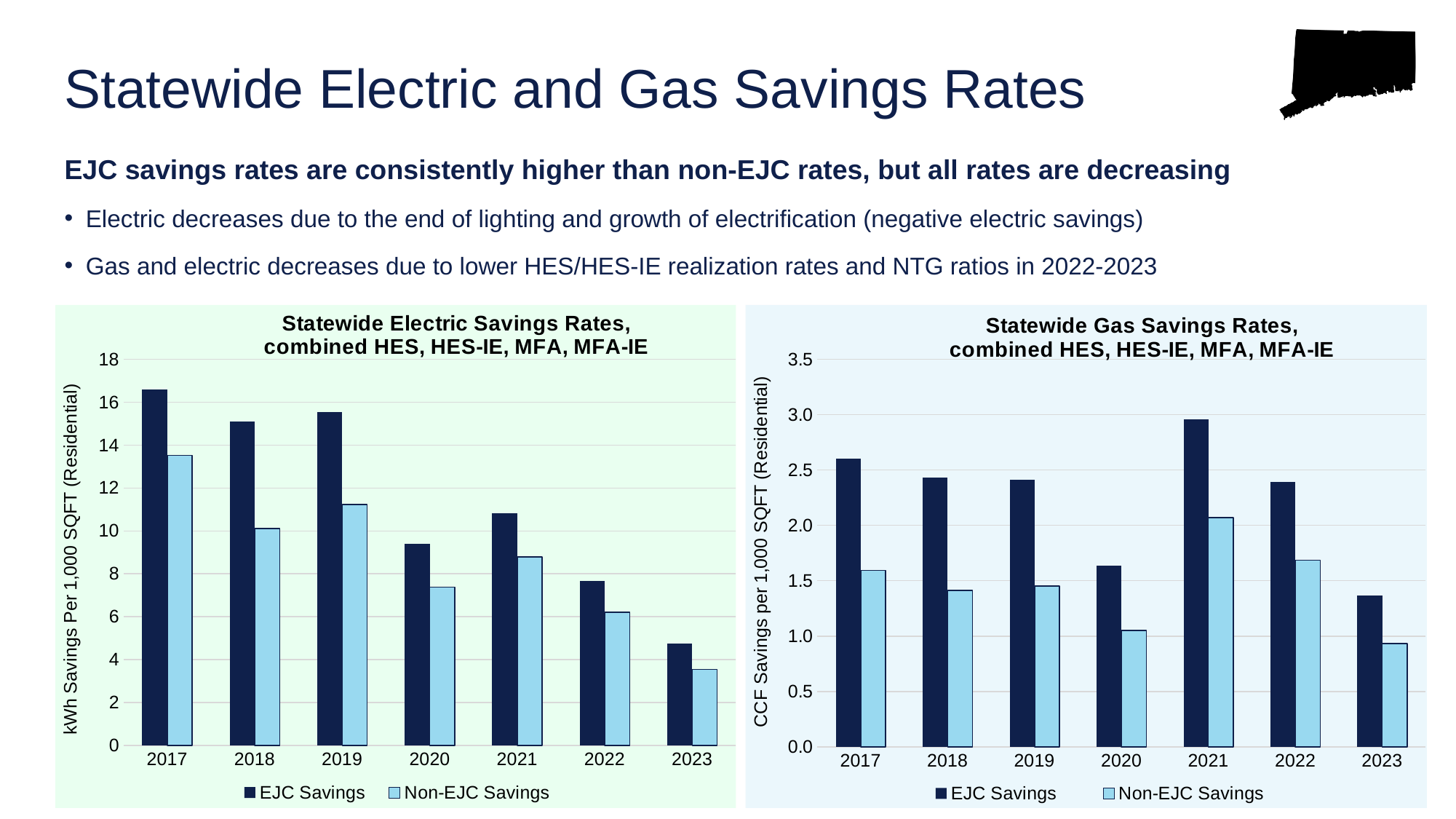
How many years are shown on the x axis of the Statewide Gas Savings Rates chart? 7 In the Statewide Electric Savings Rates chart, is the Non-EJC Savings value for 2019 greater or less than 10? greater In the Statewide Gas Savings Rates chart, which year has the highest EJC Savings value? 2021 In the Statewide Electric Savings Rates chart, which year has the highest EJC Savings value? 2017 In the Statewide Gas Savings Rates chart, which year has the lowest Non-EJC Savings value? 2023 In the Statewide Electric Savings Rates chart, which is larger, the EJC Savings value for 2020 or for 2021? 2021 In the Statewide Electric Savings Rates chart, is the EJC Savings value for 2017 greater or less than 16? greater In the Statewide Electric Savings Rates chart, which year has the lowest Non-EJC Savings value? 2023 In the Statewide Gas Savings Rates chart, is the Non-EJC Savings value for 2021 greater or less than 2.0? greater How many series does the legend of the Statewide Electric Savings Rates chart list? 2